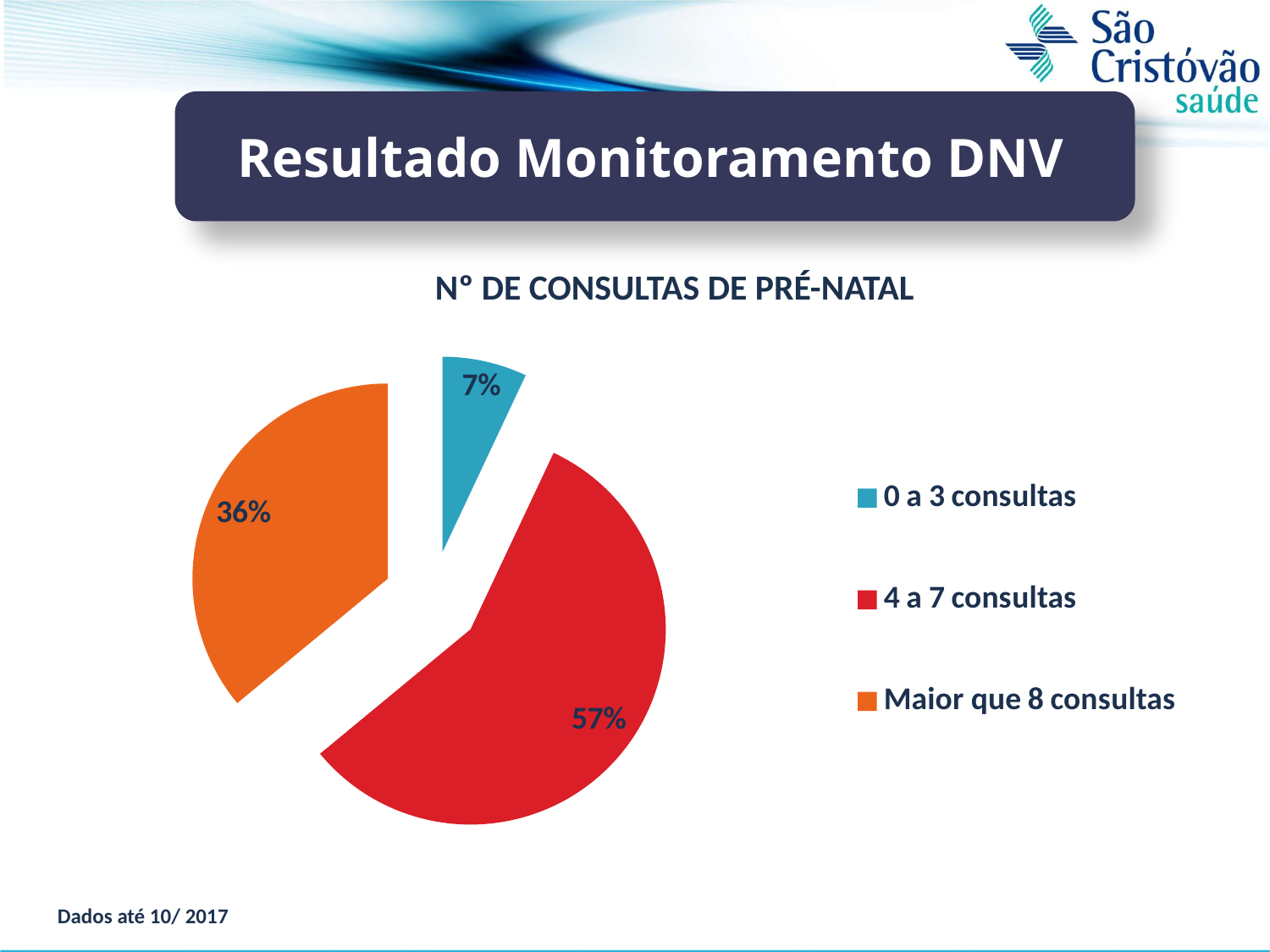
What is the difference in percentage points between 'Maior que 8 consultas' and '0 a 3 consultas'? 29 What share of the pie does '4 a 7 consultas' represent? 57% What colour is the slice for '4 a 7 consultas'? Red How many categories are shown in the pie chart? 3 What share of the pie does 'Maior que 8 consultas' represent? 36% Which category has the largest slice of the pie? 4 a 7 consultas Which category has the smallest slice of the pie? 0 a 3 consultas What is the difference in percentage points between '4 a 7 consultas' and 'Maior que 8 consultas'? 21 What kind of chart is shown on the slide? Pie chart Which is larger, the slice for 'Maior que 8 consultas' or the slice for '0 a 3 consultas'? Maior que 8 consultas What share of the pie does '0 a 3 consultas' represent? 7% What is the title of the chart? Nº DE CONSULTAS DE PRÉ-NATAL